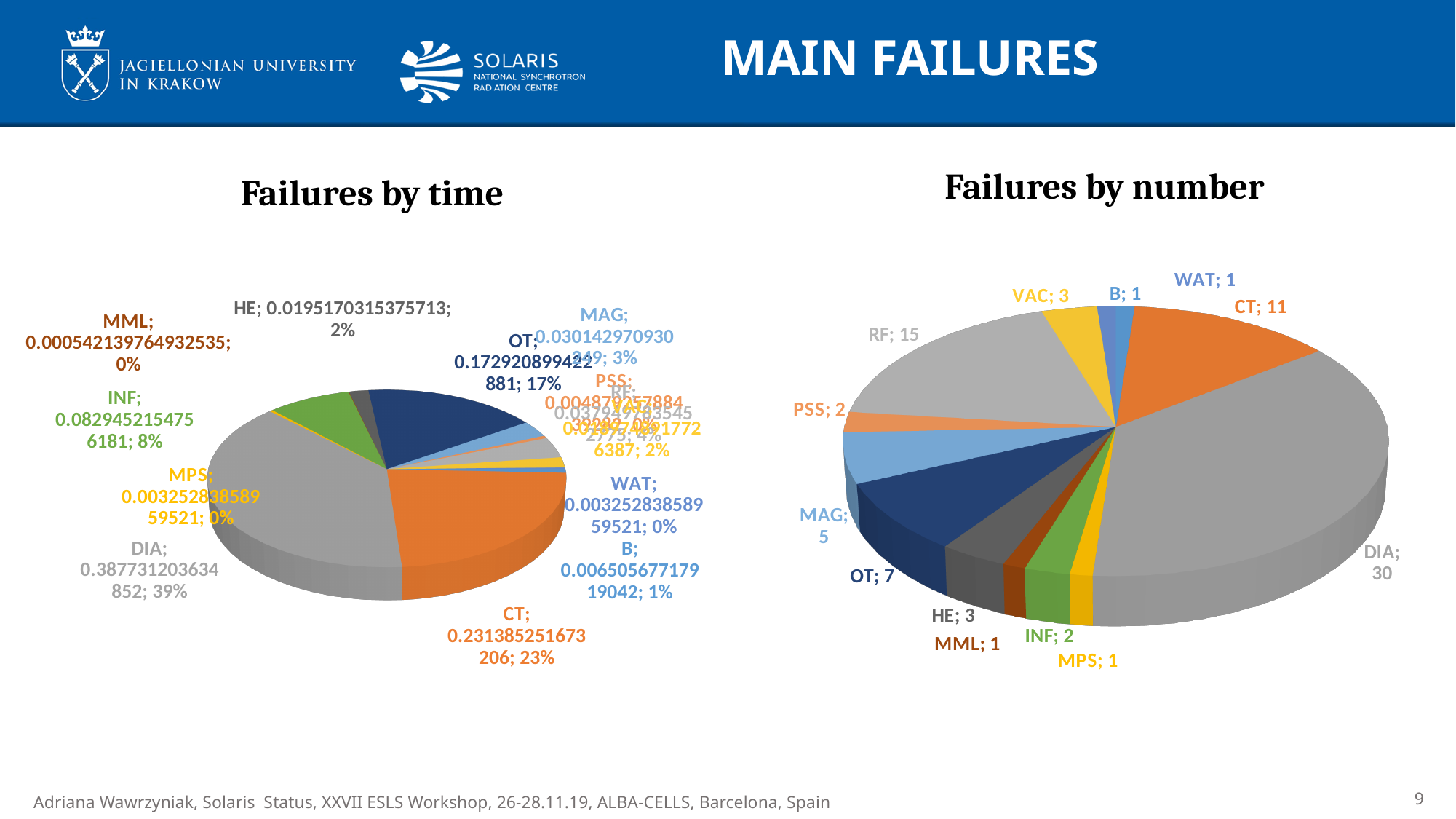
In the 'Failures by time' chart, what percentage share does CT have? 23% In the 'Failures by number' chart, which has more failures, RF or CT? RF In the 'Failures by time' chart, what percentage share does OT have? 17% In the 'Failures by number' chart, which category has the highest number of failures? DIA In the 'Failures by number' chart, how many failures are attributed to MAG? 5 In the 'Failures by number' chart, how many failures are attributed to DIA? 30 In the 'Failures by number' chart, how many failures are attributed to RF? 15 What type of chart is used for 'Failures by number'? Pie chart In the 'Failures by number' chart, what is the difference between the CT and OT failure counts? 4 In the 'Failures by number' chart, how many categories are shown? 13 In the 'Failures by time' chart, which category has the largest share? DIA In the 'Failures by time' chart, what percentage share does DIA have? 39%